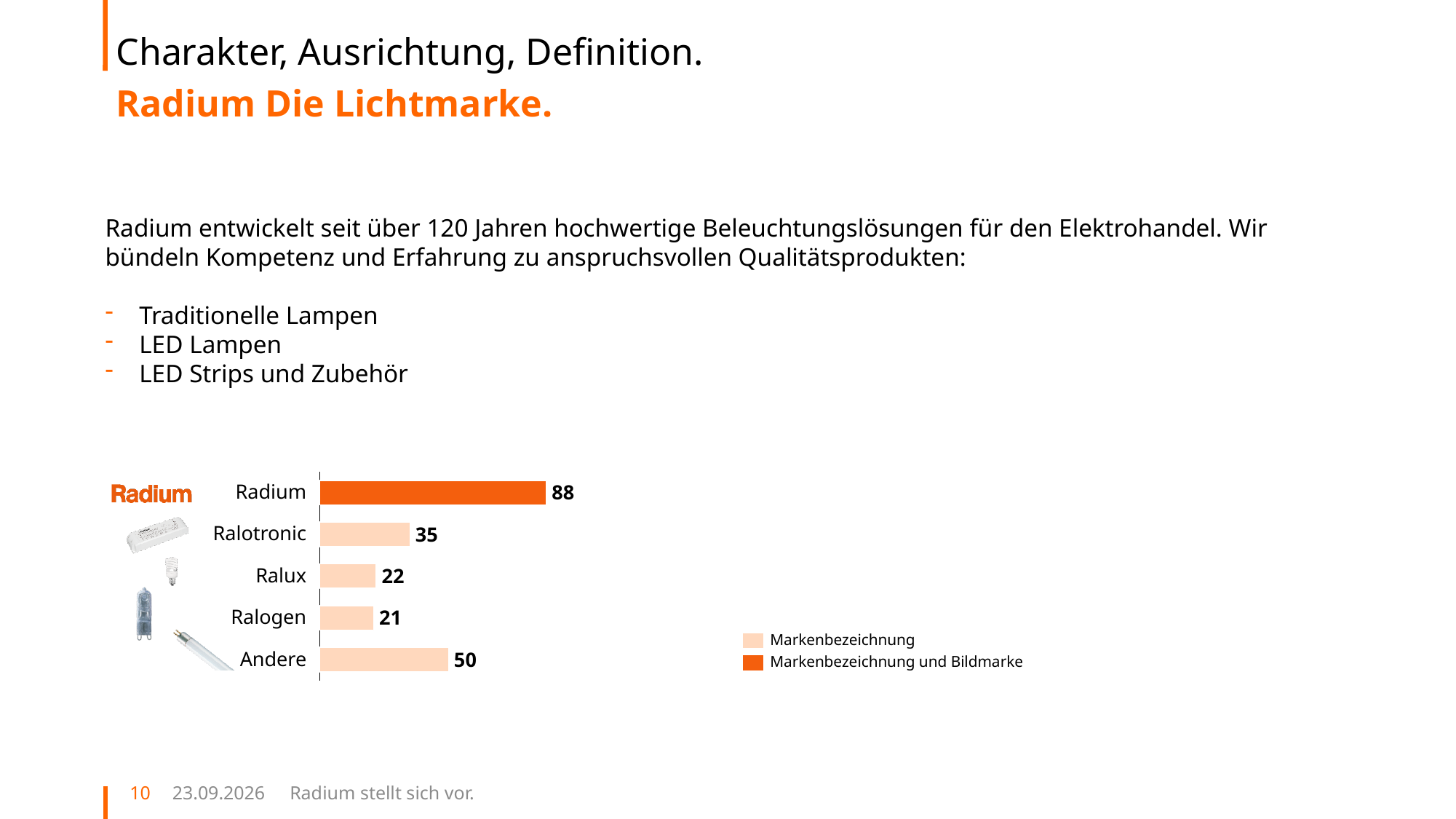
How many categories are shown in the bar chart? 5 What is the difference between the values for Radium and Andere? 38 Which is larger, the value for Andere or the value for Ralotronic? Andere What is the value for Ralotronic in the bar chart? 35 Which legend entry does the dark orange bar colour represent? Markenbezeichnung und Bildmarke What is the difference between the values for Ralotronic and Ralux? 13 What is the value for Radium in the bar chart? 88 Which category has the lowest value in the bar chart? Ralogen What kind of chart is shown on the slide? Bar chart What is the value for Andere in the bar chart? 50 Which category has the highest value in the bar chart? Radium What is the value for Ralogen in the bar chart? 21